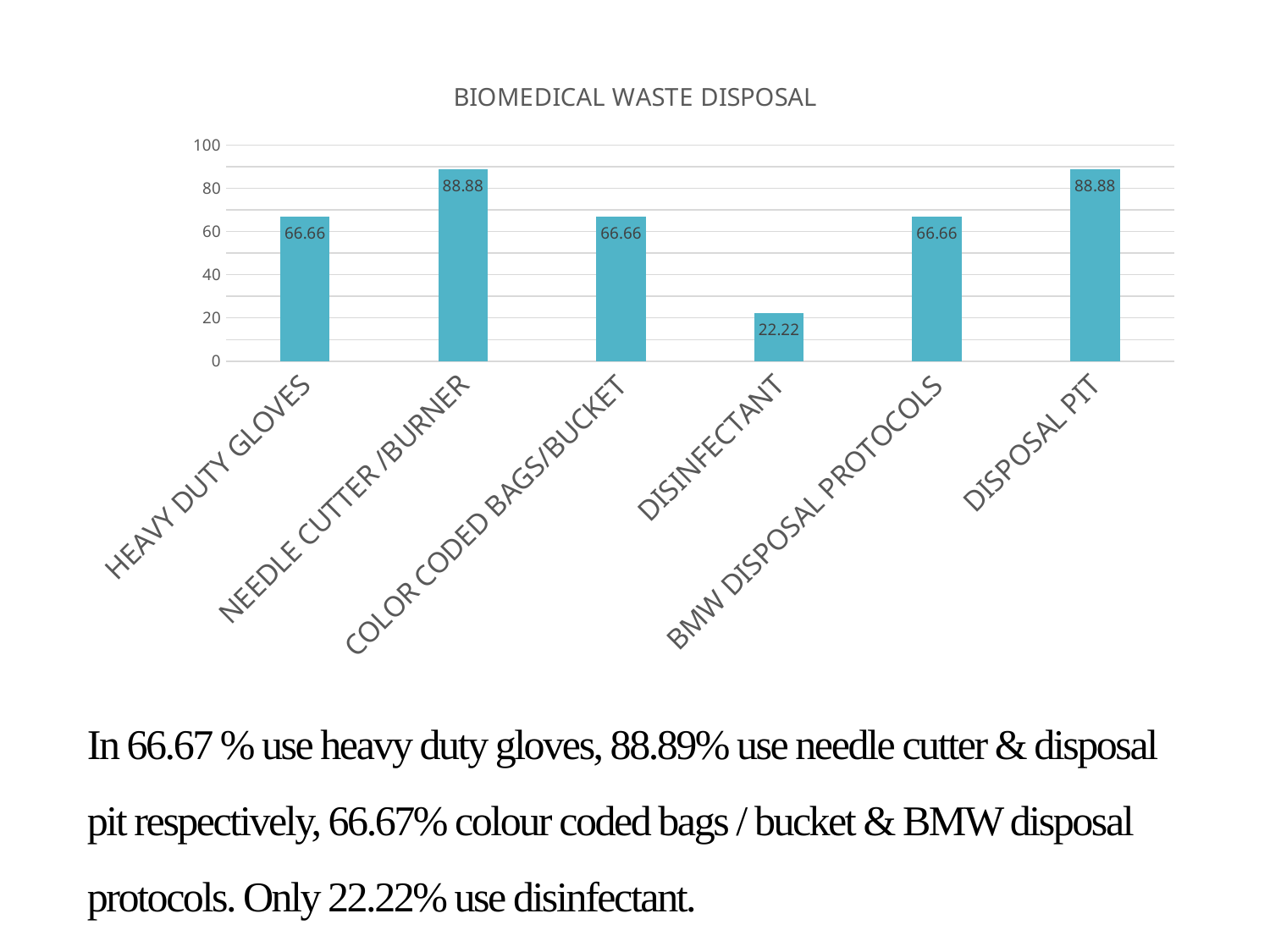
What is the value for DISINFECTANT? 22.22 What is the difference between the values for DISPOSAL PIT and DISINFECTANT? 66.66 What is the difference between the values for NEEDLE CUTTER /BURNER and COLOR CODED BAGS/BUCKET? 22.22 What kind of chart is shown on the slide? Bar chart What is the value for BMW DISPOSAL PROTOCOLS? 66.66 How many categories are shown on the chart? 6 What is the title of the chart? BIOMEDICAL WASTE DISPOSAL Is the value for DISPOSAL PIT greater or less than 80? greater Which is larger, the value for COLOR CODED BAGS/BUCKET or the value for DISINFECTANT? COLOR CODED BAGS/BUCKET What is the value for NEEDLE CUTTER /BURNER? 88.88 Which category has the lowest value? DISINFECTANT What is the value for HEAVY DUTY GLOVES? 66.66